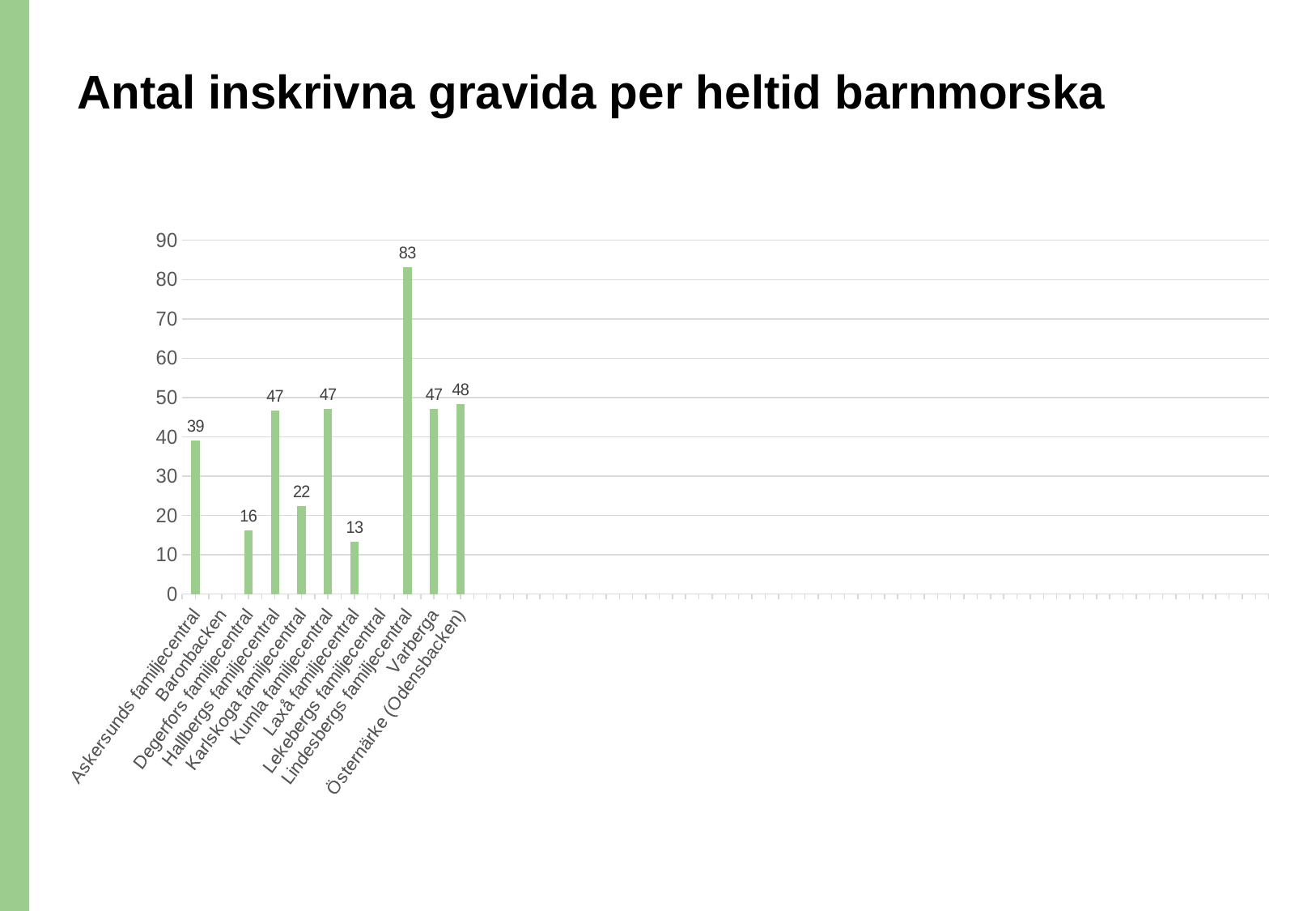
What is the value for Varberga? 47 What is the value for Askersunds familjecentral? 39 What is the value for Laxå familjecentral? 13 What is the value for Lindesbergs familjecentral? 83 Among the categories with a plotted bar, which has the lowest value? Laxå familjecentral How many bars with data labels are plotted in the chart? 9 Is the value for Hallbergs familjecentral greater or less than 40? greater Which is larger, the value for Karlskoga familjecentral or Degerfors familjecentral? Karlskoga familjecentral What is the difference between the values for Lindesbergs familjecentral and Östernärke (Odensbacken)? 35 Which category has the highest value? Lindesbergs familjecentral What is the title of the slide? Antal inskrivna gravida per heltid barnmorska What kind of chart is shown on the slide? bar chart